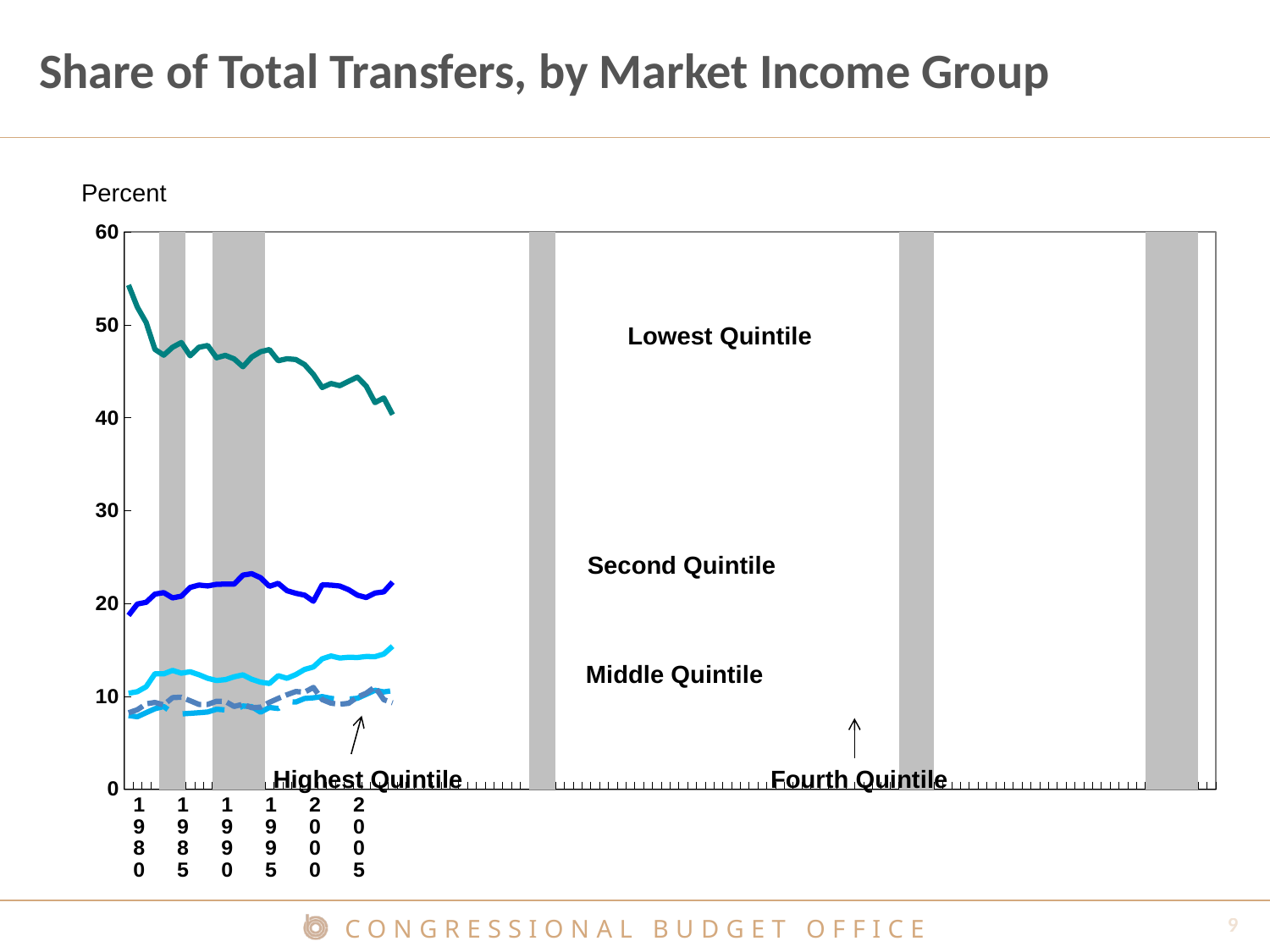
Does the share of total transfers for the Middle Quintile rise or fall from 1980 to 2005? rise Is the value for the Lowest Quintile in 2005 greater or less than 50? less Does the share of total transfers for the Lowest Quintile rise or fall from 1980 to 2005? fall Which income group has the highest share of total transfers throughout the period shown? Lowest Quintile How many income groups (quintiles) are plotted on the chart? 5 Is the value for the Second Quintile in 2005 greater or less than 30? less Which has the larger share of total transfers in 1990, the Lowest Quintile or the Second Quintile? Lowest Quintile Is the value for the Middle Quintile in 2005 greater or less than 10? greater What unit is shown on the vertical axis of the chart? Percent Which has the larger share of total transfers in 2000, the Second Quintile or the Middle Quintile? Second Quintile What kind of chart is shown on the slide? line chart